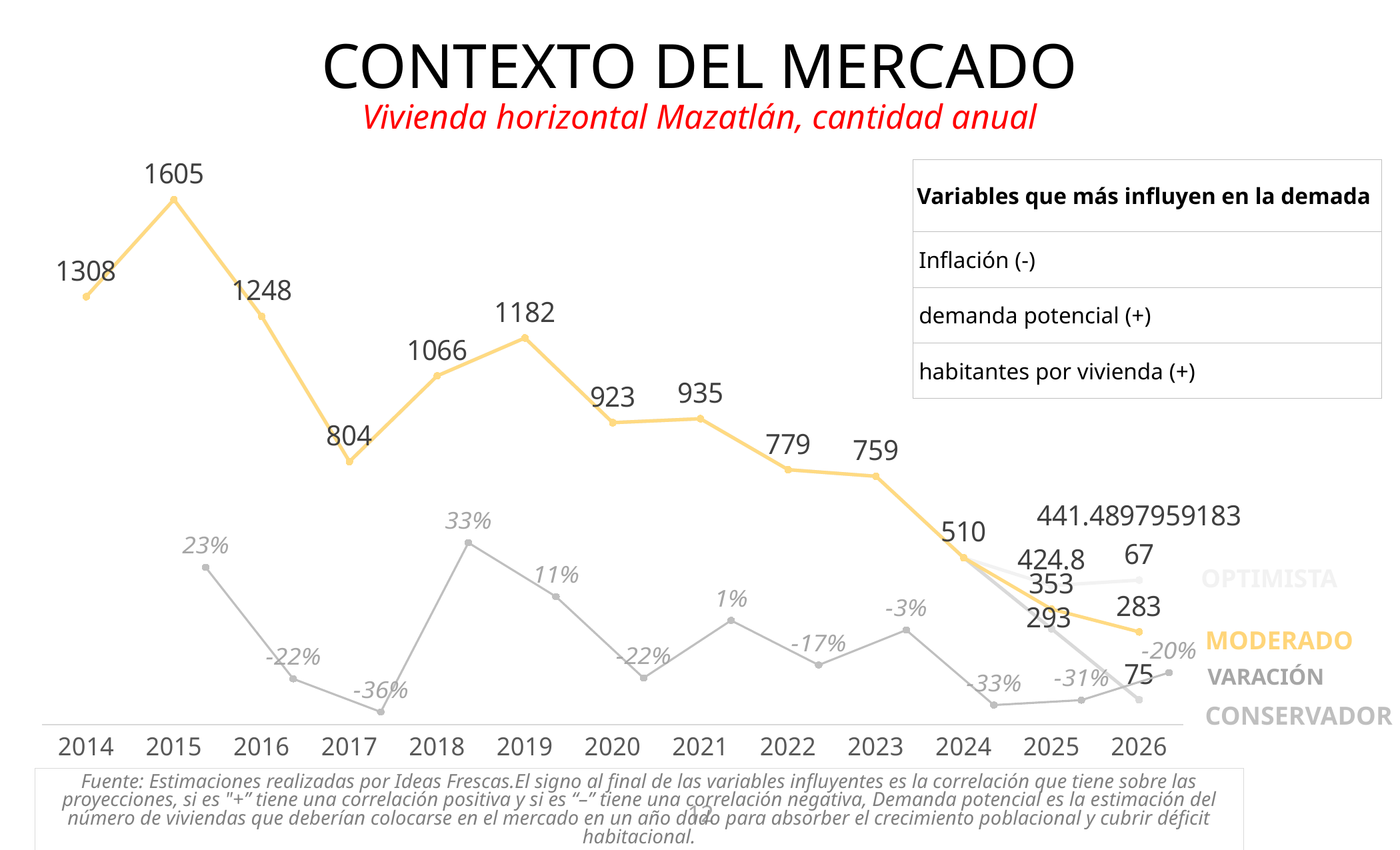
What is the VARIACIÓN value shown for 2018? 33% What is the difference between the MODERADO values for 2023 and 2024? 249 How many years are shown on the x axis? 13 What is the red subtitle of the chart? Vivienda horizontal Mazatlán, cantidad anual Does the MODERADO series rise or fall from 2019 to 2026? Fall What is the MODERADO value for 2015? 1605 What is the MODERADO value for 2017? 804 In which year does the MODERADO series reach its lowest value? 2026 Which year has the larger MODERADO value, 2020 or 2021? 2021 What kind of chart is shown on the slide? Line chart What is the difference between the MODERADO values for 2015 and 2014? 297 In which year does the MODERADO series reach its highest value? 2015